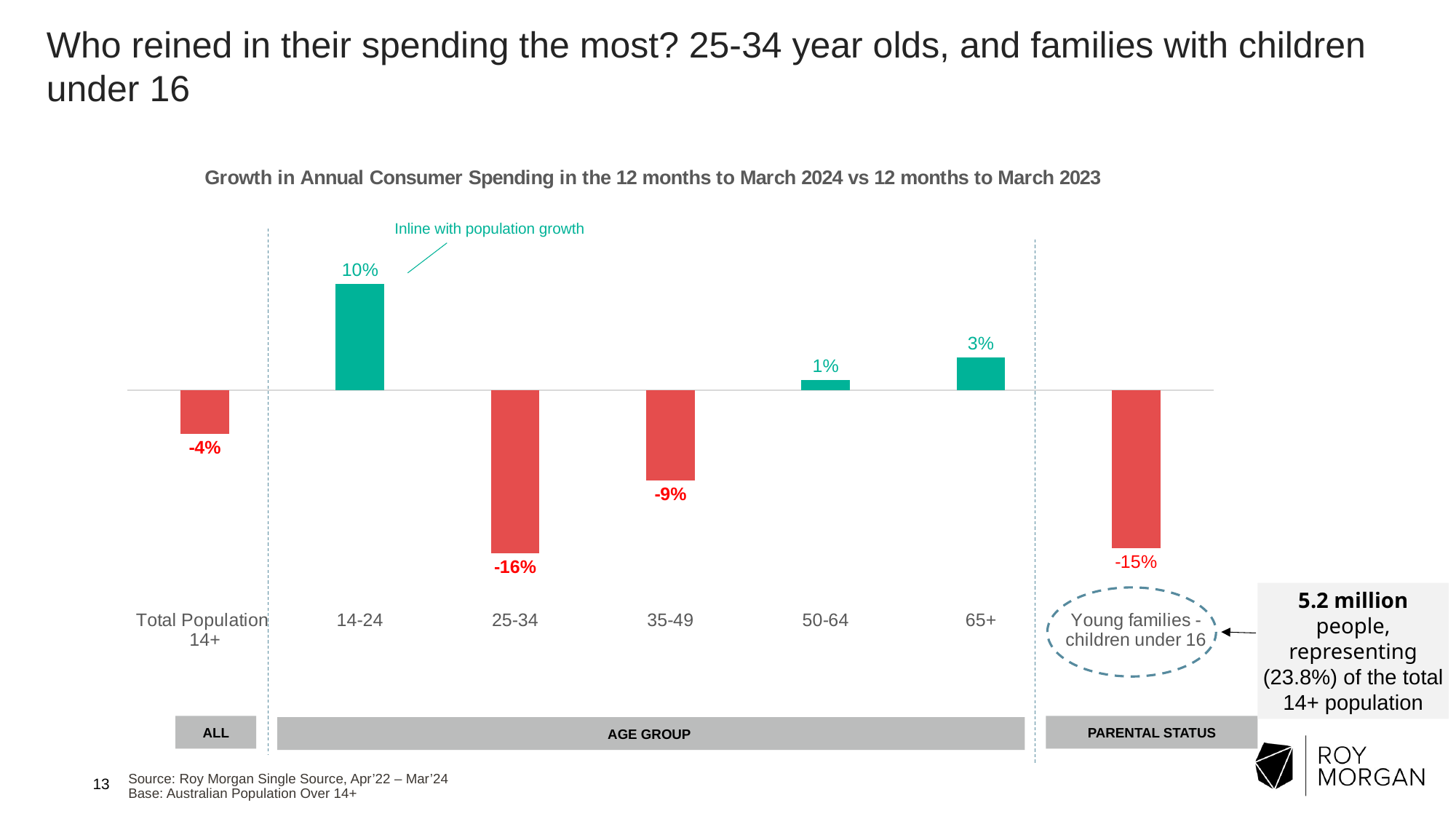
Which bar is annotated as 'Inline with population growth'? 14-24 What is the difference between the growth for the 14-24 age group and the 35-49 age group? 19 percentage points What is the growth in annual consumer spending for the 65+ age group? 3% What is the growth in annual consumer spending for Young families - children under 16? -15% Which category has the lowest growth in annual consumer spending? 25-34 Which has the larger growth in annual consumer spending, the 50-64 age group or the 65+ age group? 65+ How many categories are plotted in the chart? 7 What is the growth in annual consumer spending for the 25-34 age group? -16% Which category has the highest growth in annual consumer spending? 14-24 What is the title of the chart? Growth in Annual Consumer Spending in the 12 months to March 2024 vs 12 months to March 2023 What is the growth in annual consumer spending for the Total Population 14+? -4% What kind of chart is shown on the slide? Bar chart